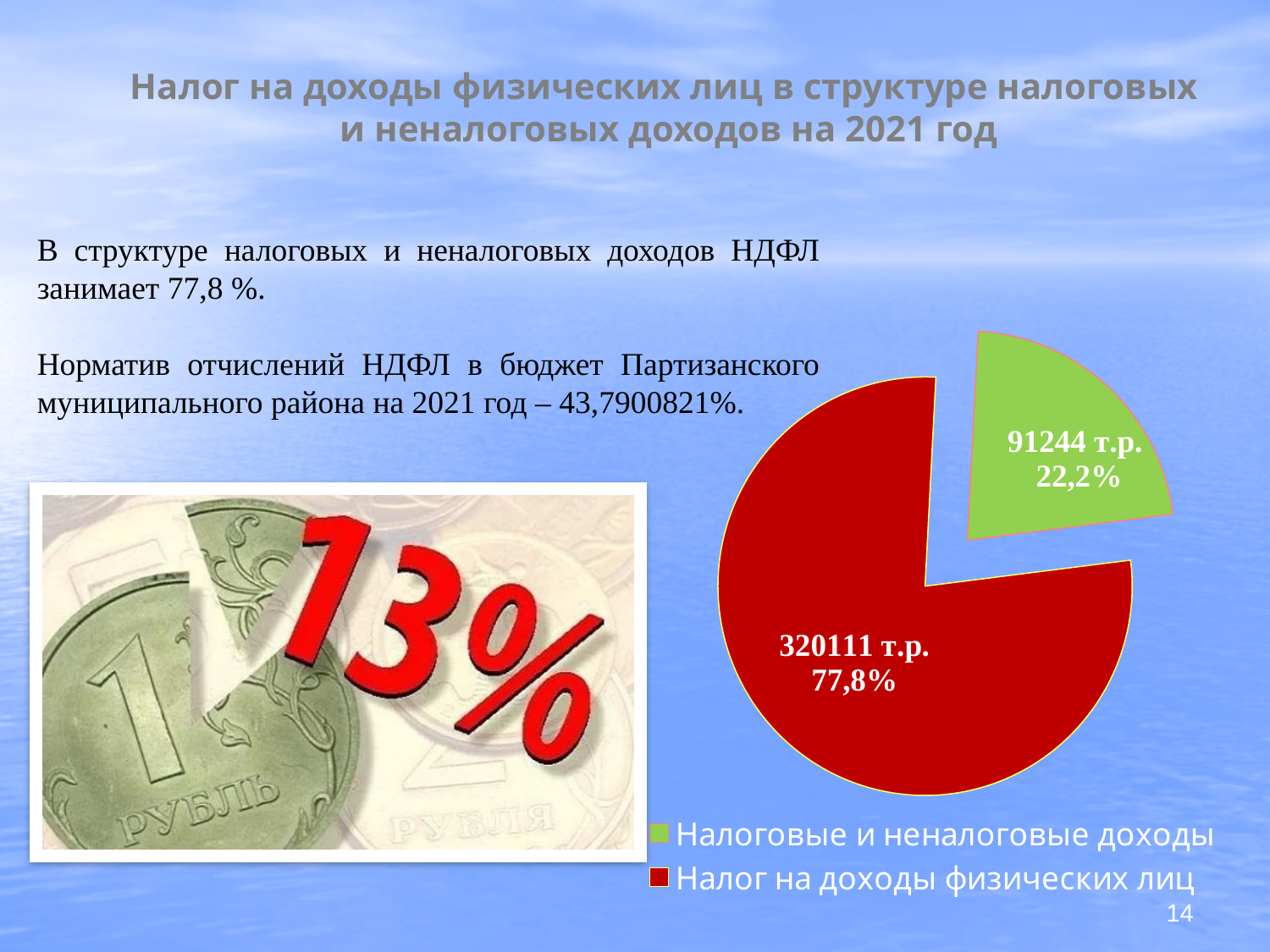
Which slice of the pie chart is the smallest? Налоговые и неналоговые доходы How many entries does the legend of the pie chart list? 2 What share of the pie does the slice "Налоговые и неналоговые доходы" take? 22,2% Which is larger: the value for "Налог на доходы физических лиц" or for "Налоговые и неналоговые доходы"? Налог на доходы физических лиц What share of the pie does the slice "Налог на доходы физических лиц" take? 77,8% What value is shown for the slice "Налог на доходы физических лиц"? 320111 т.р. How many slices does the pie chart have? 2 What kind of chart is shown on the slide? pie chart What colour is the slice for "Налог на доходы физических лиц" in the pie chart? red What is the difference between the values for "Налог на доходы физических лиц" and "Налоговые и неналоговые доходы"? 228867 т.р. What value is shown for the slice "Налоговые и неналоговые доходы"? 91244 т.р. Which slice of the pie chart is the largest? Налог на доходы физических лиц